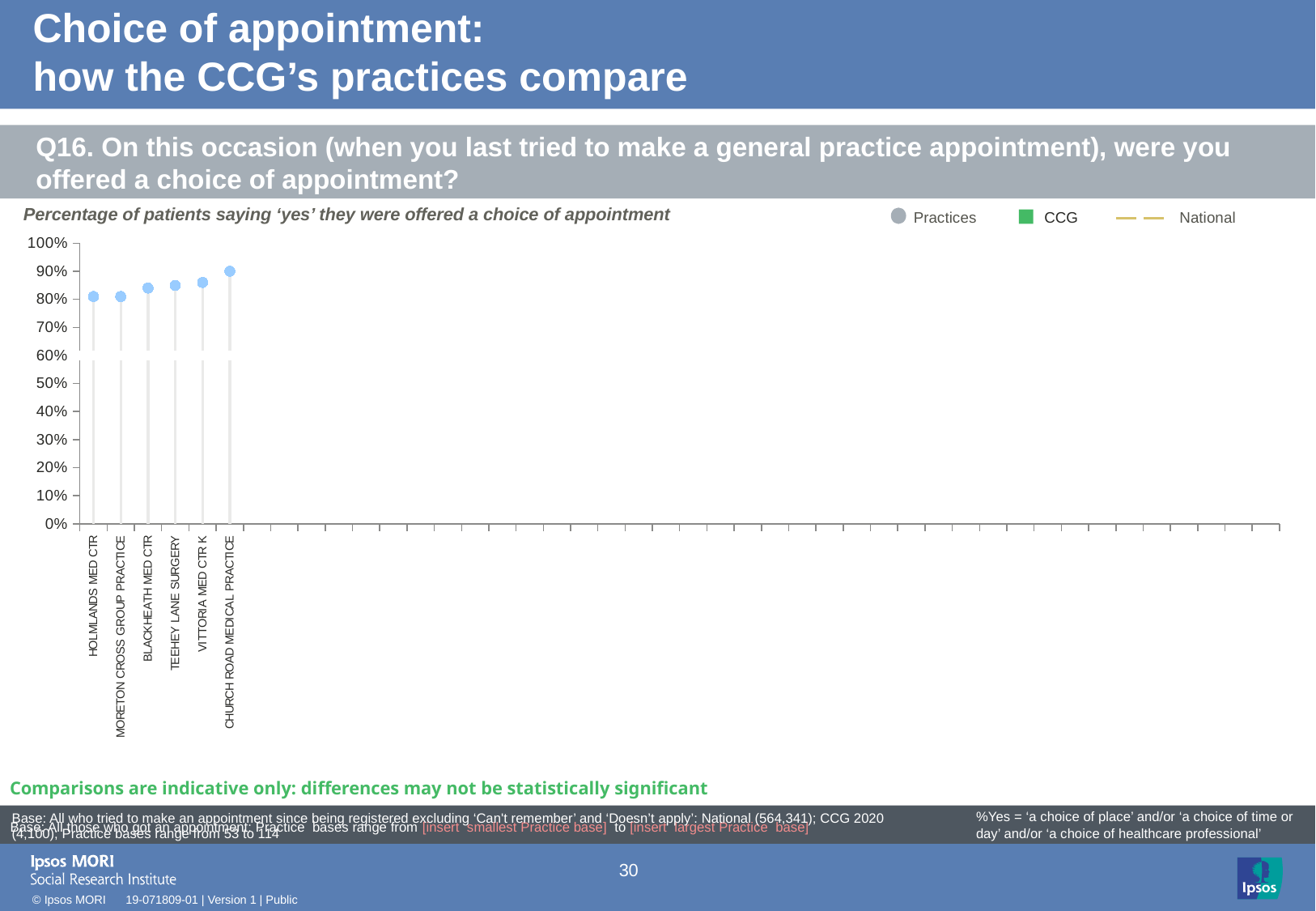
Is the value for HOLMLANDS MED CTR greater or less than 70%? greater Which has the higher value: VITTORIA MED CTR K or MORETON CROSS GROUP PRACTICE? VITTORIA MED CTR K What is the title of the chart? Percentage of patients saying 'yes' they were offered a choice of appointment Is the value for VITTORIA MED CTR K greater or less than 90%? less Which practice has the highest percentage of patients saying they were offered a choice of appointment? CHURCH ROAD MEDICAL PRACTICE How many entries does the chart legend list? 3 What colour is used for the CCG entry in the legend? green How many practices are plotted on the chart? 6 Do the plotted values rise or fall moving from left to right across the practices? rise Is the value for BLACKHEATH MED CTR greater or less than 60%? greater Which has the higher value: CHURCH ROAD MEDICAL PRACTICE or HOLMLANDS MED CTR? CHURCH ROAD MEDICAL PRACTICE